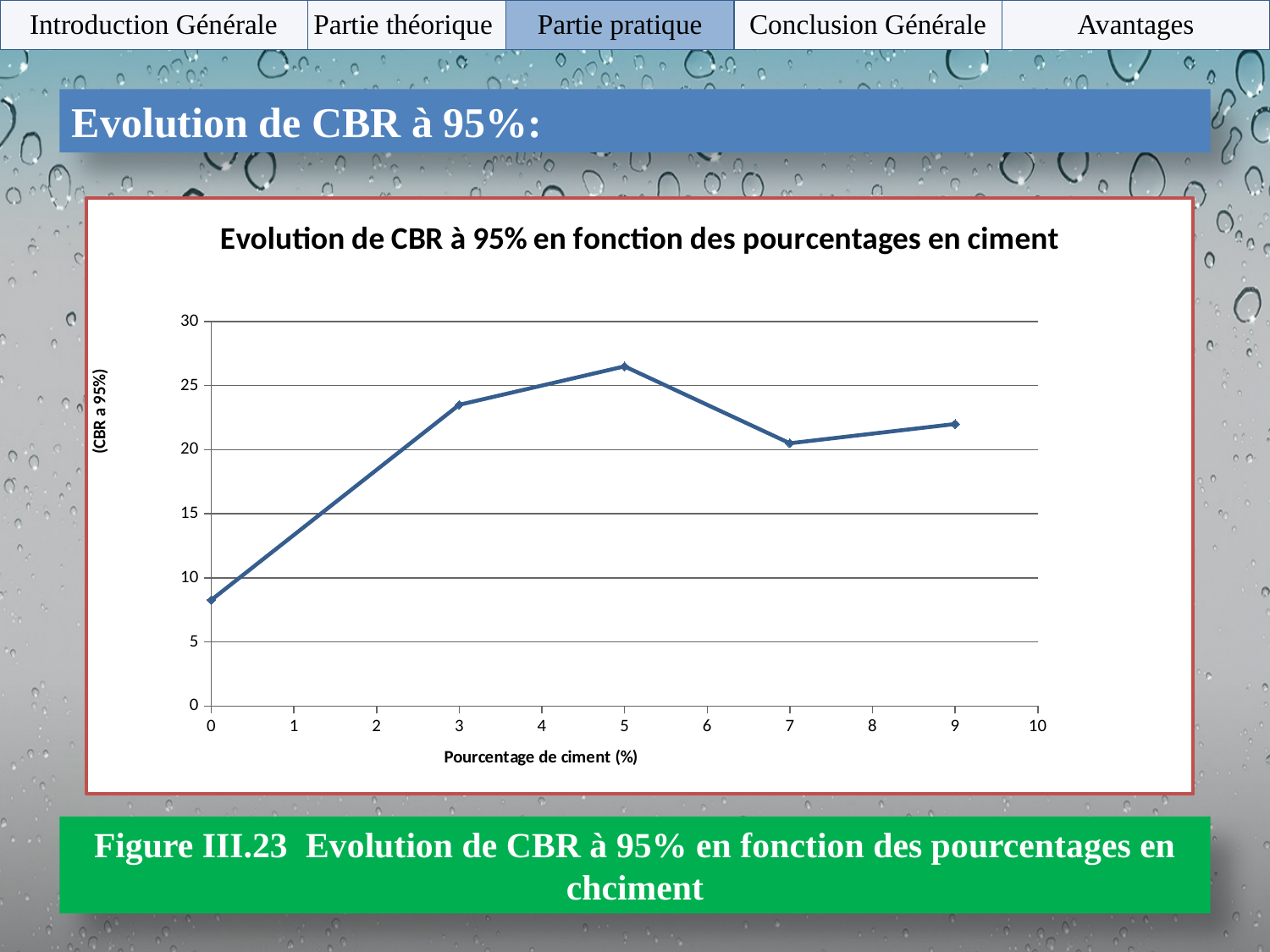
Is the CBR value at 3% cement greater or less than 20? greater At which cement percentage is the CBR value lowest? 0 Is the CBR value at 0% cement greater or less than 10? less How many data points are plotted on the line? 5 Is the CBR value at 9% cement greater or less than 25? less What kind of chart is shown on the slide? line chart What is the title of the chart? Evolution de CBR à 95% en fonction des pourcentages en ciment What is the label of the x axis? Pourcentage de ciment (%) At which cement percentage is the CBR value highest? 5 Which has the larger CBR value: 3% cement or 7% cement? 3% cement Does the CBR value rise or fall between 5% and 7% cement? fall